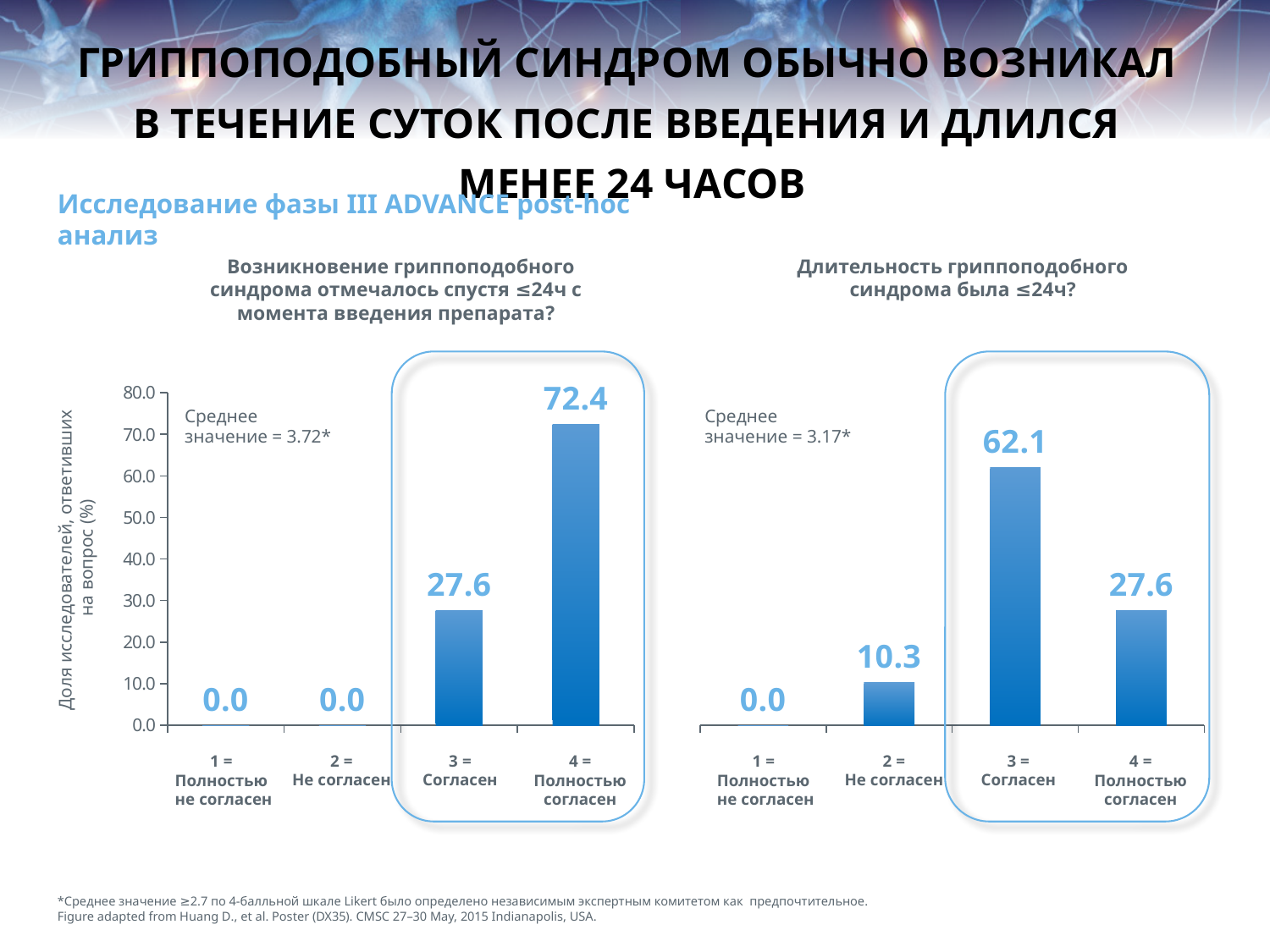
How many categories are shown on the x axis of the left chart? 4 In the right chart, what is the value for '3 = Согласен'? 62.1 In the right chart, which category has the highest value? 3 = Согласен What type of chart is the right chart? Bar chart In the left chart, what is the value for '3 = Согласен'? 27.6 In the right chart, what is the difference between the values for '3 = Согласен' and '4 = Полностью согласен'? 34.5 In the right chart, which is larger: the value for '2 = Не согласен' or the value for '4 = Полностью согласен'? 4 = Полностью согласен In the left chart (Возникновение гриппоподобного синдрома...), what is the value for '4 = Полностью согласен'? 72.4 In the left chart, which category has the highest value? 4 = Полностью согласен In the right chart (Длительность гриппоподобного синдрома была ≤24ч?), what is the value for '2 = Не согласен'? 10.3 In the left chart, what is the difference between the values for '4 = Полностью согласен' and '3 = Согласен'? 44.8 What mean value (Среднее значение) is stated on the right chart? 3.17*